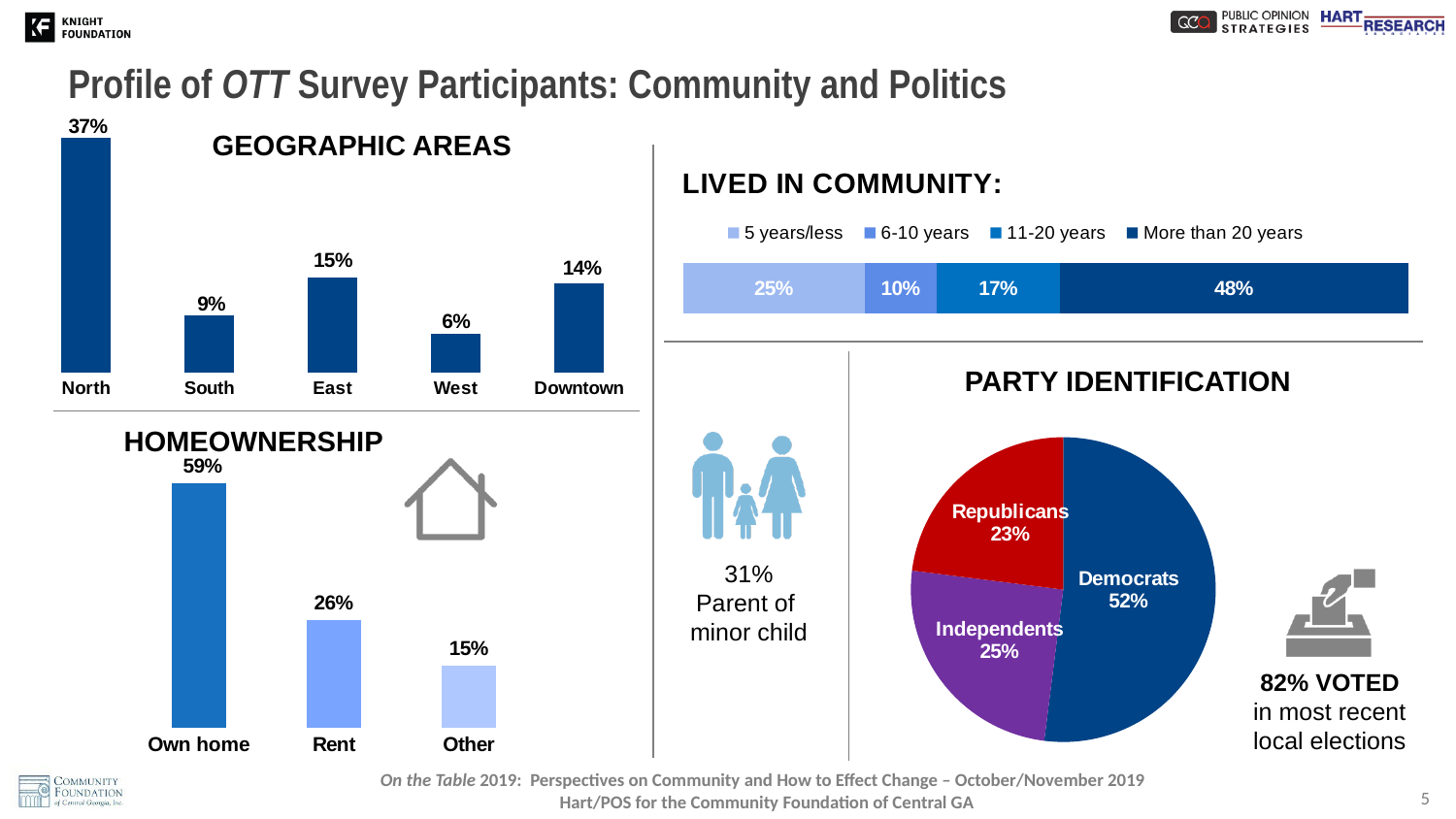
In the Geographic Areas chart, what is the difference between East and South? 6% In the Geographic Areas chart, which area has the lowest value? West In the Lived in Community chart, what is the value for More than 20 years? 48% In the Lived in Community chart, how many series does the legend list? 4 What kind of chart is the Party Identification chart? Pie chart In the Geographic Areas chart, what is the value for North? 37% In the Homeownership chart, what is the value for Rent? 26% In the Geographic Areas chart, how many areas are shown? 5 In the Homeownership chart, which category is highest? Own home In the Homeownership chart, what is the difference between Own home and Other? 44% In the Lived in Community chart, which is larger: 5 years/less or 11-20 years? 5 years/less In the Party Identification chart, what share of the pie is Independents? 25%